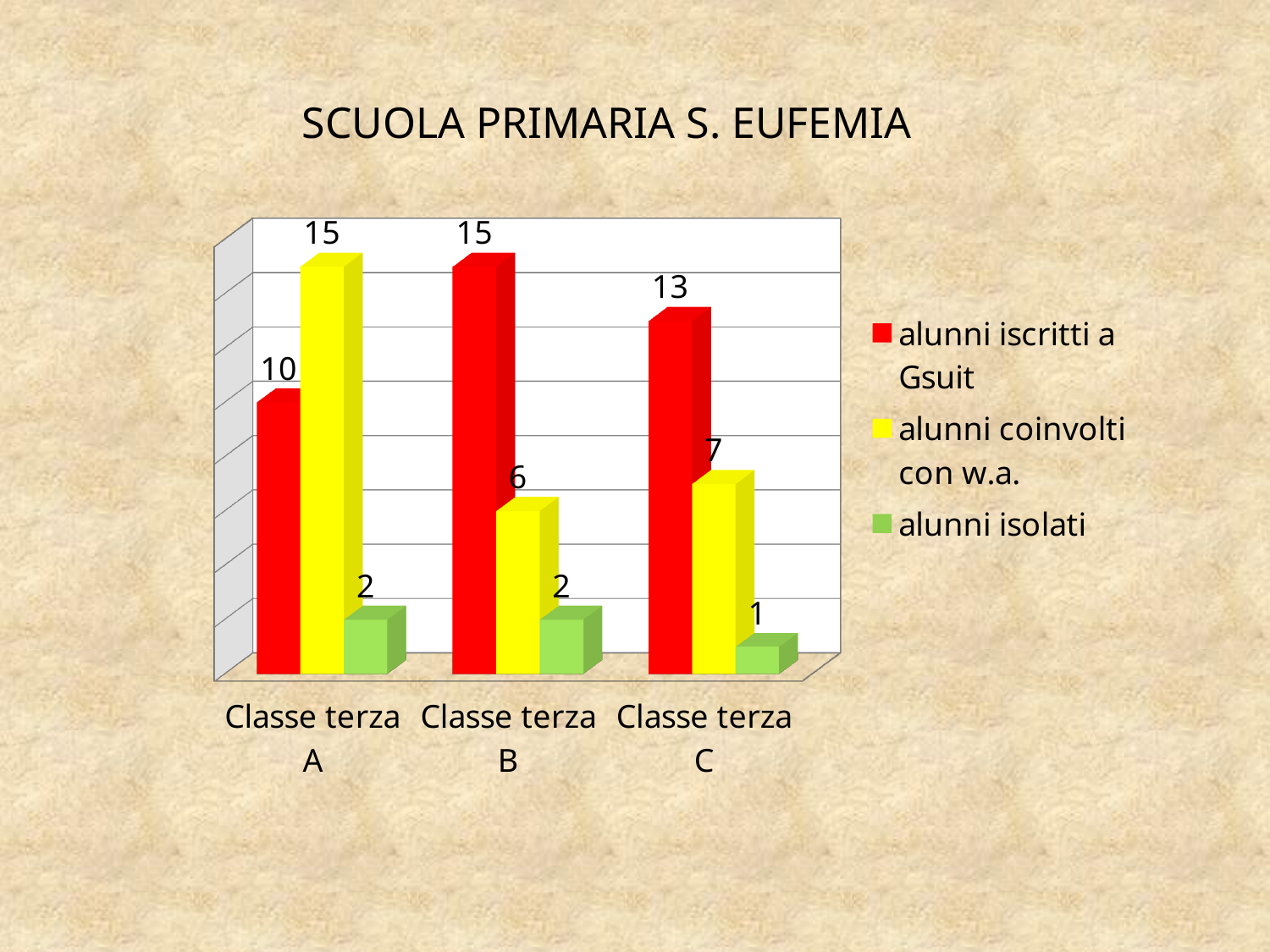
How many classes are shown on the x axis? 3 Which class has the highest value for 'alunni iscritti a Gsuit'? Classe terza B Which is larger for Classe terza A: 'alunni iscritti a Gsuit' or 'alunni coinvolti con w.a.'? alunni coinvolti con w.a. What colour represents 'alunni isolati' in the chart? green What is the value of 'alunni coinvolti con w.a.' for Classe terza C? 7 How many series does the legend list? 3 What kind of chart is shown on the slide? bar chart Which class has the lowest value for 'alunni coinvolti con w.a.'? Classe terza B What is the difference between 'alunni iscritti a Gsuit' and 'alunni coinvolti con w.a.' for Classe terza B? 9 What is the value of 'alunni isolati' for Classe terza C? 1 What is the value of 'alunni iscritti a Gsuit' for Classe terza A? 10 What is the value of 'alunni coinvolti con w.a.' for Classe terza B? 6